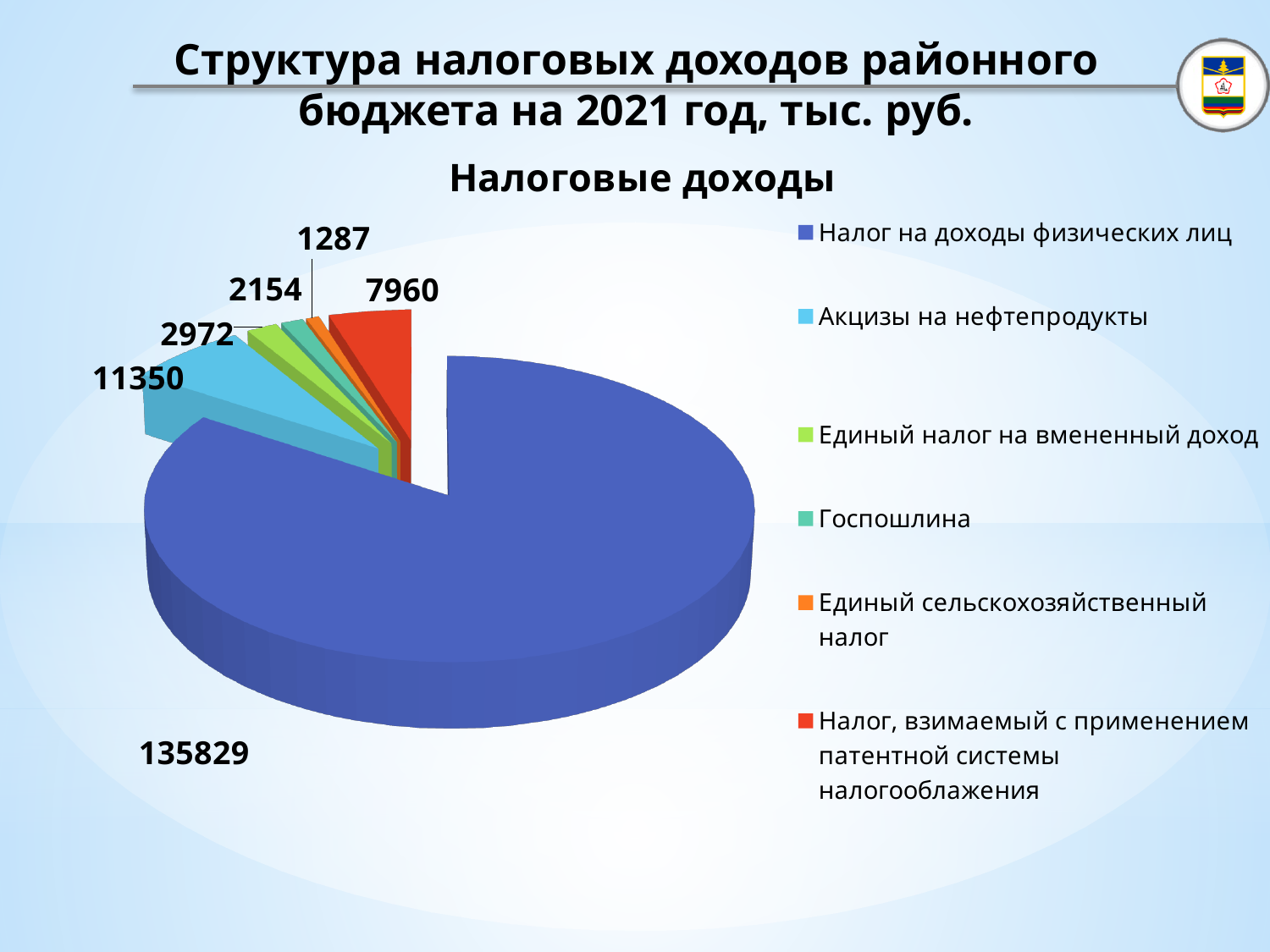
Which category has the largest slice of the pie? Налог на доходы физических лиц What is the value for Госпошлина? 2154 What is the value for Единый сельскохозяйственный налог? 1287 How many categories does the legend list? 6 Which category has the smallest slice of the pie? Единый сельскохозяйственный налог Which is larger: Госпошлина or Единый налог на вмененный доход? Единый налог на вмененный доход What is the value for Единый налог на вмененный доход? 2972 What is the value for Налог на доходы физических лиц? 135829 What is the difference between the values for Акцизы на нефтепродукты and Налог, взимаемый с применением патентной системы налогооблажения? 3390 What is the value for Налог, взимаемый с применением патентной системы налогооблажения? 7960 What is the value for Акцизы на нефтепродукты? 11350 What type of chart is shown on the slide? Pie chart